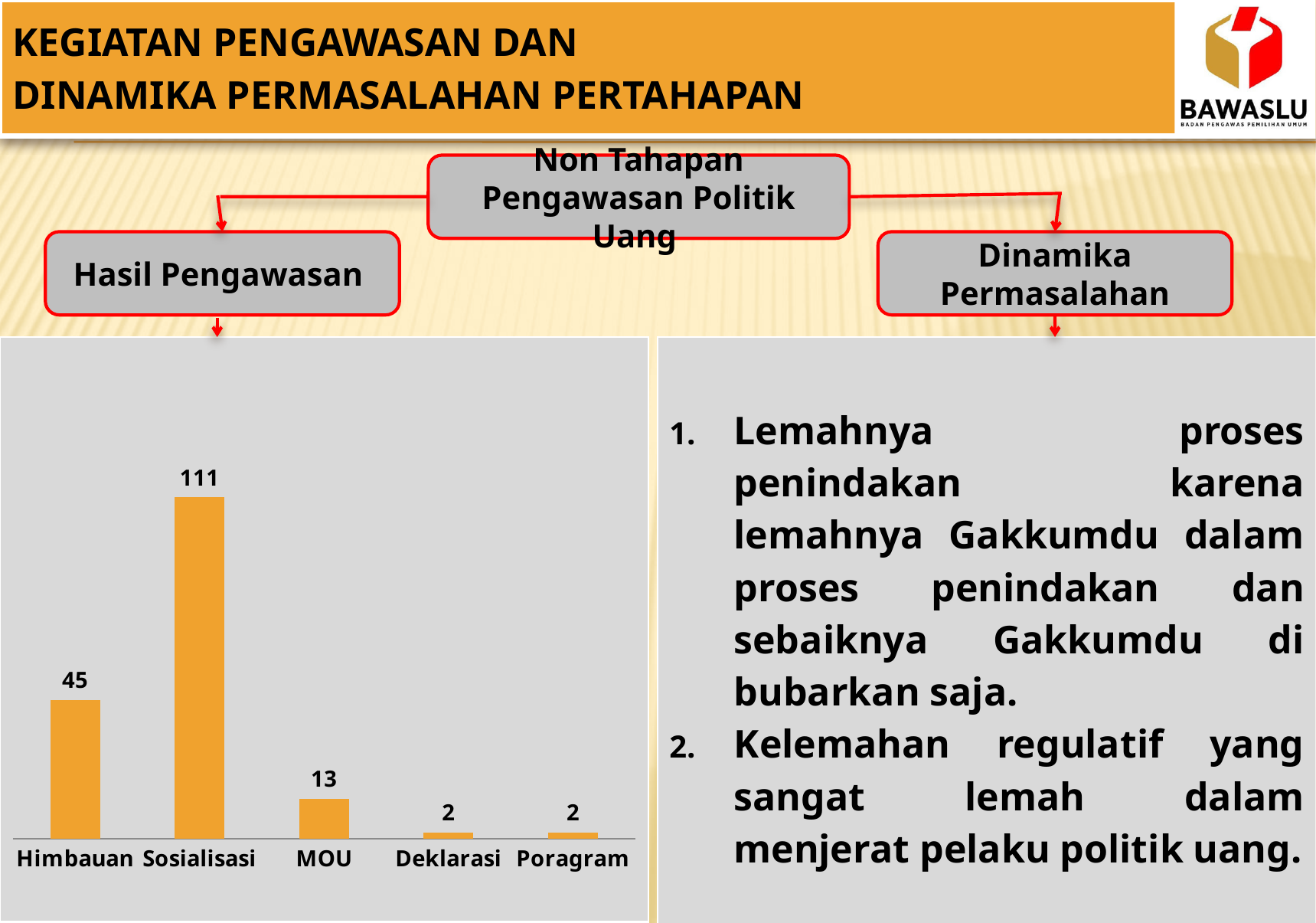
What is the difference between the values for Himbauan and MOU? 32 What is the value for Himbauan in the bar chart? 45 What colour are the bars in the chart? Orange Which category has the highest value in the bar chart? Sosialisasi What is the value for Sosialisasi in the bar chart? 111 Which is larger, the value for Himbauan or the value for MOU? Himbauan What is the value for MOU in the bar chart? 13 How many categories are shown in the bar chart? 5 What is the total of all the values shown in the bar chart? 173 What kind of chart is shown on the slide? Bar chart What is the value for Deklarasi in the bar chart? 2 What is the difference between the values for Sosialisasi and Himbauan? 66